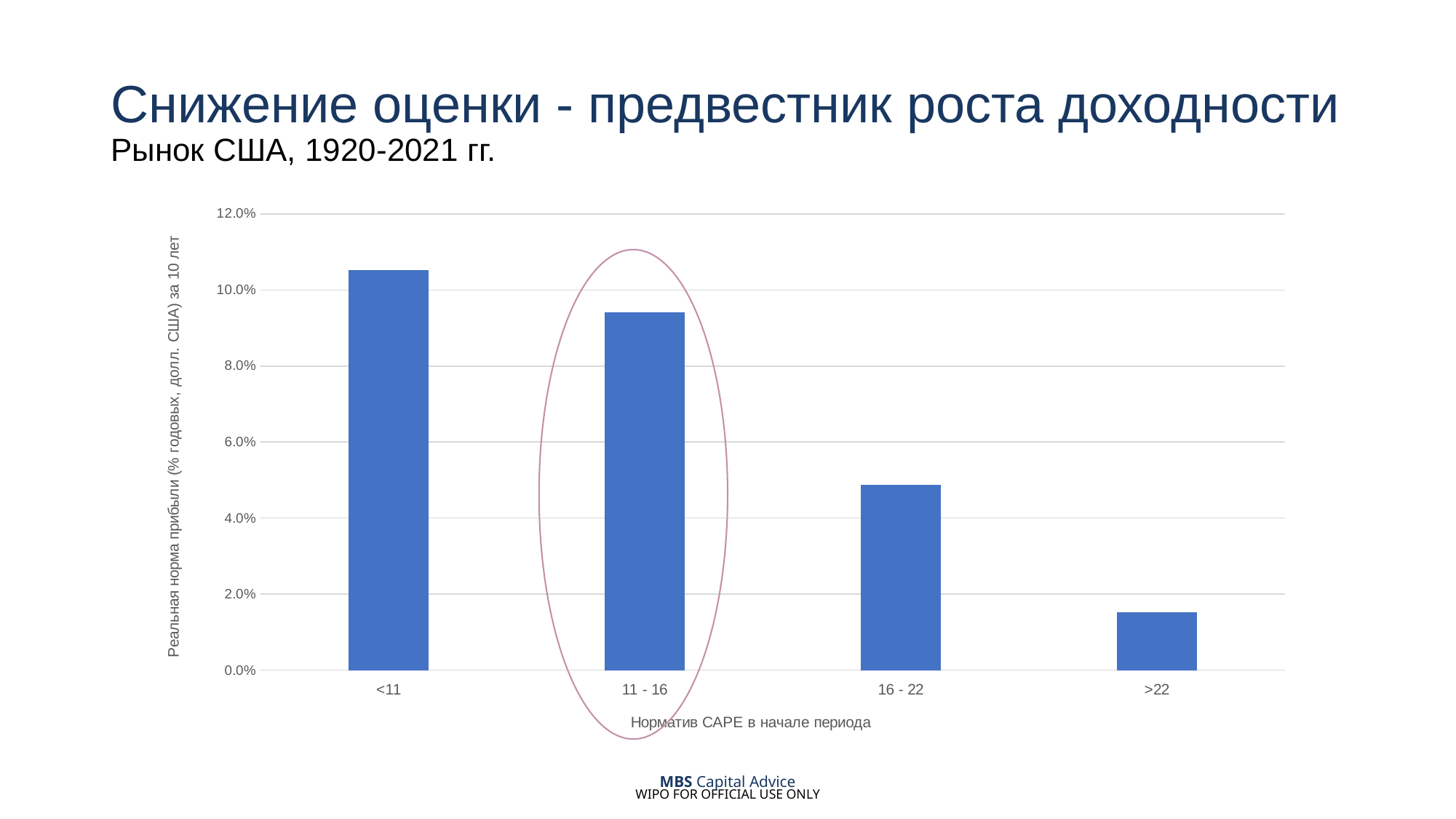
What is the label of the x axis? Норматив CAPE в начале периода Do the values rise or fall as the CAPE category increases along the x axis? fall Is the value for the 16 - 22 category greater or less than 6.0%? less Is the value for the 11 - 16 category greater or less than 10.0%? less How many CAPE categories are shown on the x axis? 4 Is the value for the >22 category greater or less than 2.0%? less Which bar is circled on the chart? 11 - 16 Which CAPE category has the lowest real rate of return? >22 Which CAPE category has the highest real rate of return? <11 What kind of chart is shown on the slide? bar chart Which is larger, the value for 11 - 16 or the value for 16 - 22? 11 - 16